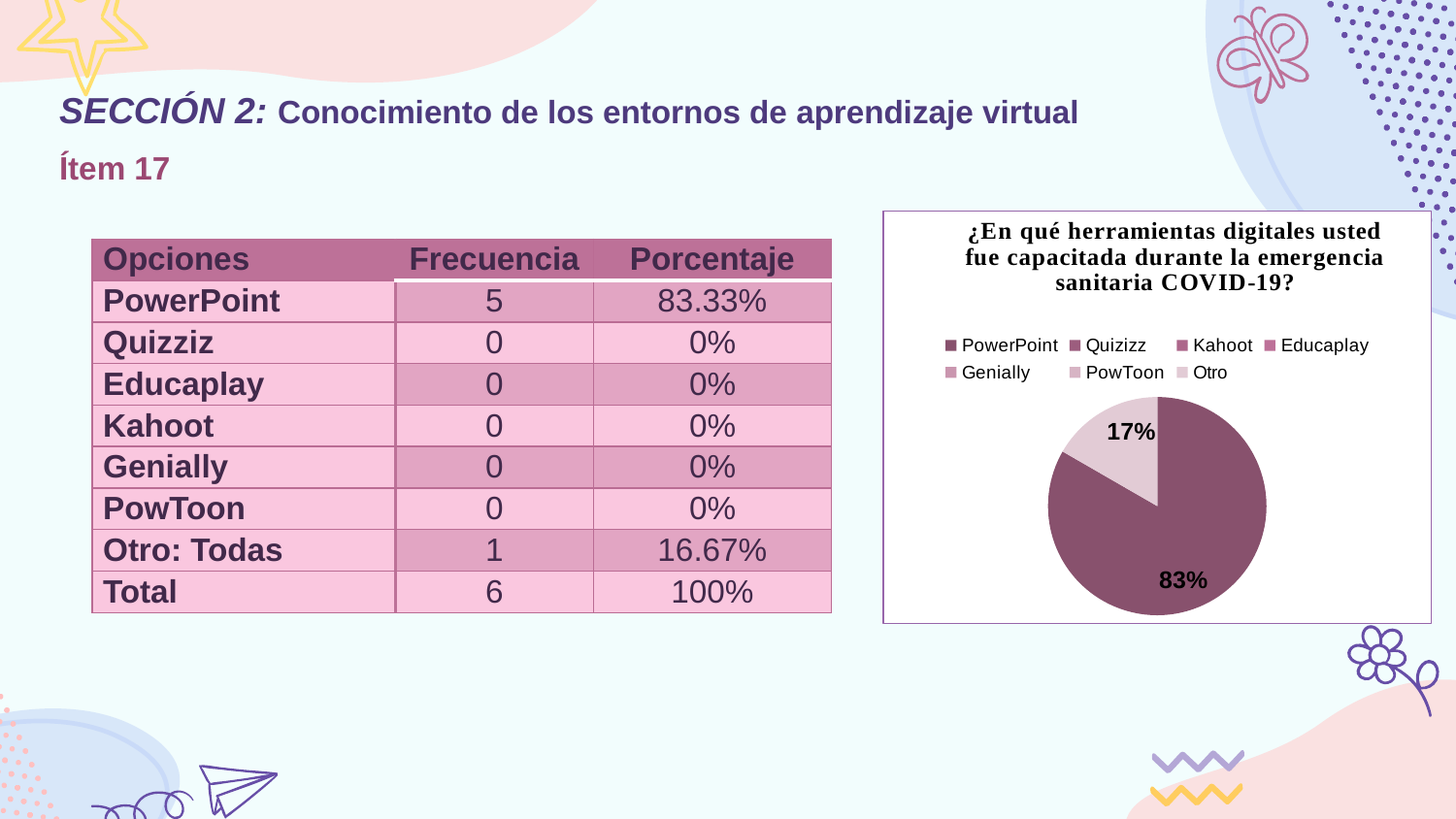
Which category has the largest slice in the pie chart? PowerPoint Which of the two labelled slices is smaller, PowerPoint or Otro? Otro Is the value for the Otro slice greater or less than 50%? less What percentage does the Otro slice of the pie chart show? 17% Which legend entry appears first in the pie chart's legend? PowerPoint How many entries does the pie chart's legend list? 7 What type of chart is shown on the slide? pie chart What share of the pie does the PowerPoint slice represent? 83% How many slices with data labels are visible in the pie chart? 2 What is the difference in percentage points between the PowerPoint slice and the Otro slice? 66 What percentage does the PowerPoint slice of the pie chart show? 83% What is the title of the pie chart? ¿En qué herramientas digitales usted fue capacitada durante la emergencia sanitaria COVID-19?